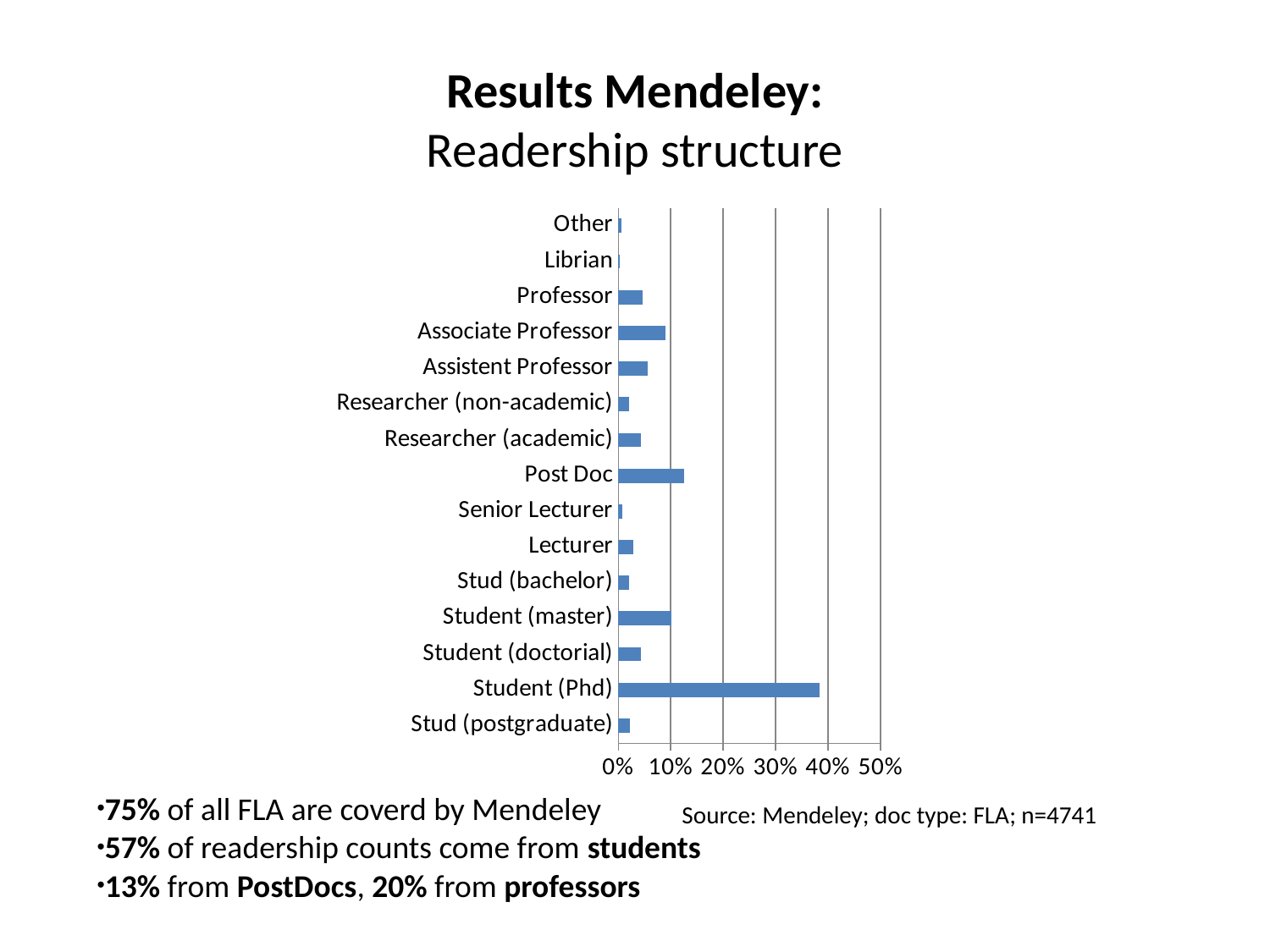
Which category has the highest value in the chart? Student (Phd) Which category has the lowest value in the chart? Librian Which is larger, the value for Post Doc or the value for Student (master)? Post Doc Which is larger, the value for Associate Professor or the value for Professor? Associate Professor Which is larger, the value for Lecturer or the value for Senior Lecturer? Lecturer What kind of chart is shown on the slide? bar chart How many categories are plotted in the chart? 15 What is the highest value shown on the chart's percentage axis? 50% Is the value for Post Doc greater or less than 20%? less Is the value for Professor greater or less than 10%? less Is the value for Post Doc greater or less than 10%? greater